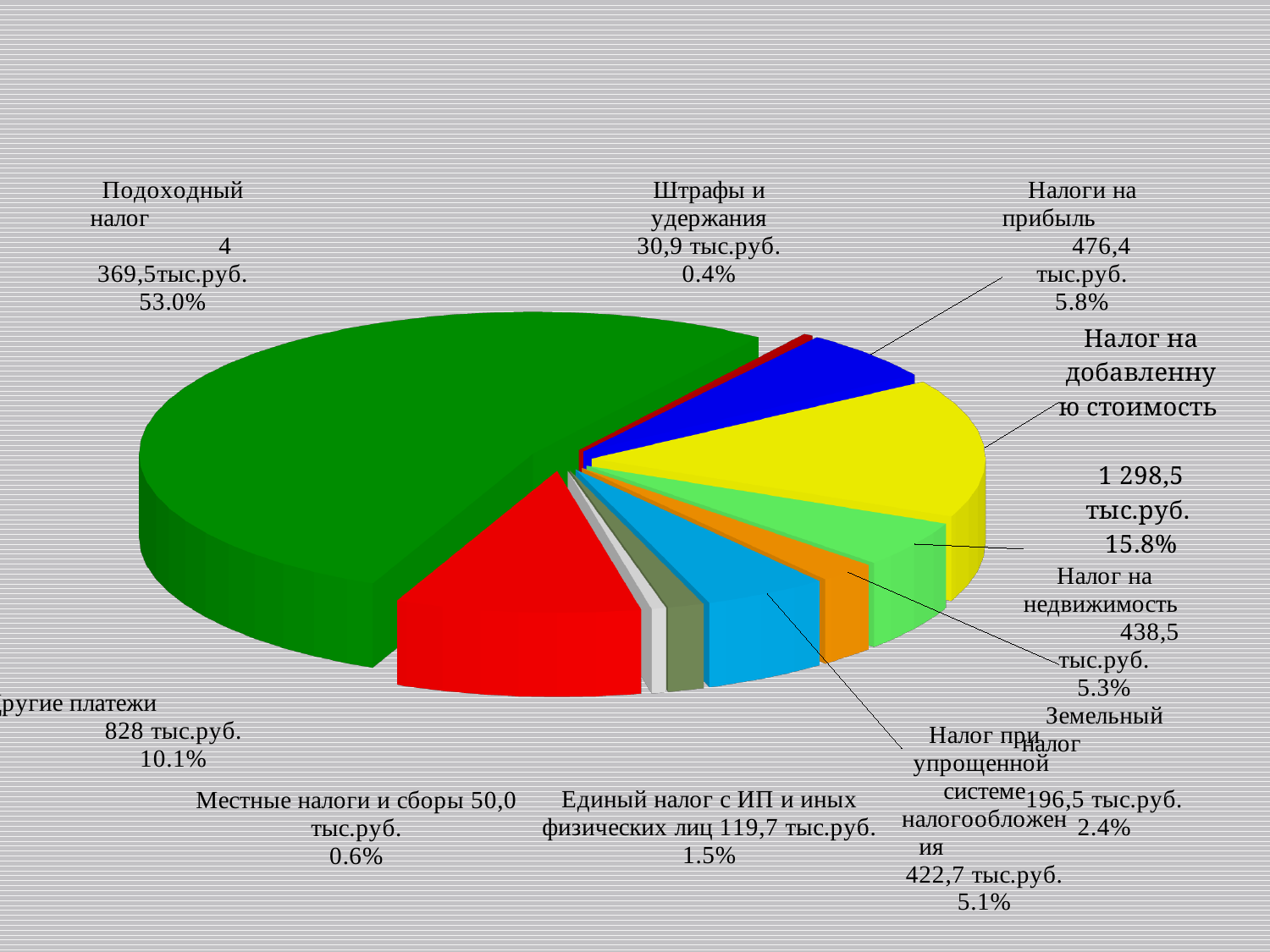
What kind of chart is shown on the slide? pie chart What share of the pie does Налог при упрощенной системе налогообложения account for? 5.1% What share of the pie does Земельный налог account for? 2.4% What is the difference in percentage share between Налог на добавленную стоимость and Другие платежи? 5.7% How many slices does the pie chart have? 10 What is the value shown for Единый налог с ИП и иных физических лиц? 119,7 тыс.руб. Which category has the largest slice of the pie? Подоходный налог Which category has the smallest slice of the pie? Штрафы и удержания What is the value shown for Налог на добавленную стоимость? 1 298,5 тыс.руб. Which is larger, Налоги на прибыль or Налог на недвижимость? Налоги на прибыль What is the value shown for Другие платежи? 828 тыс.руб. What share of the pie does Подоходный налог account for? 53.0%